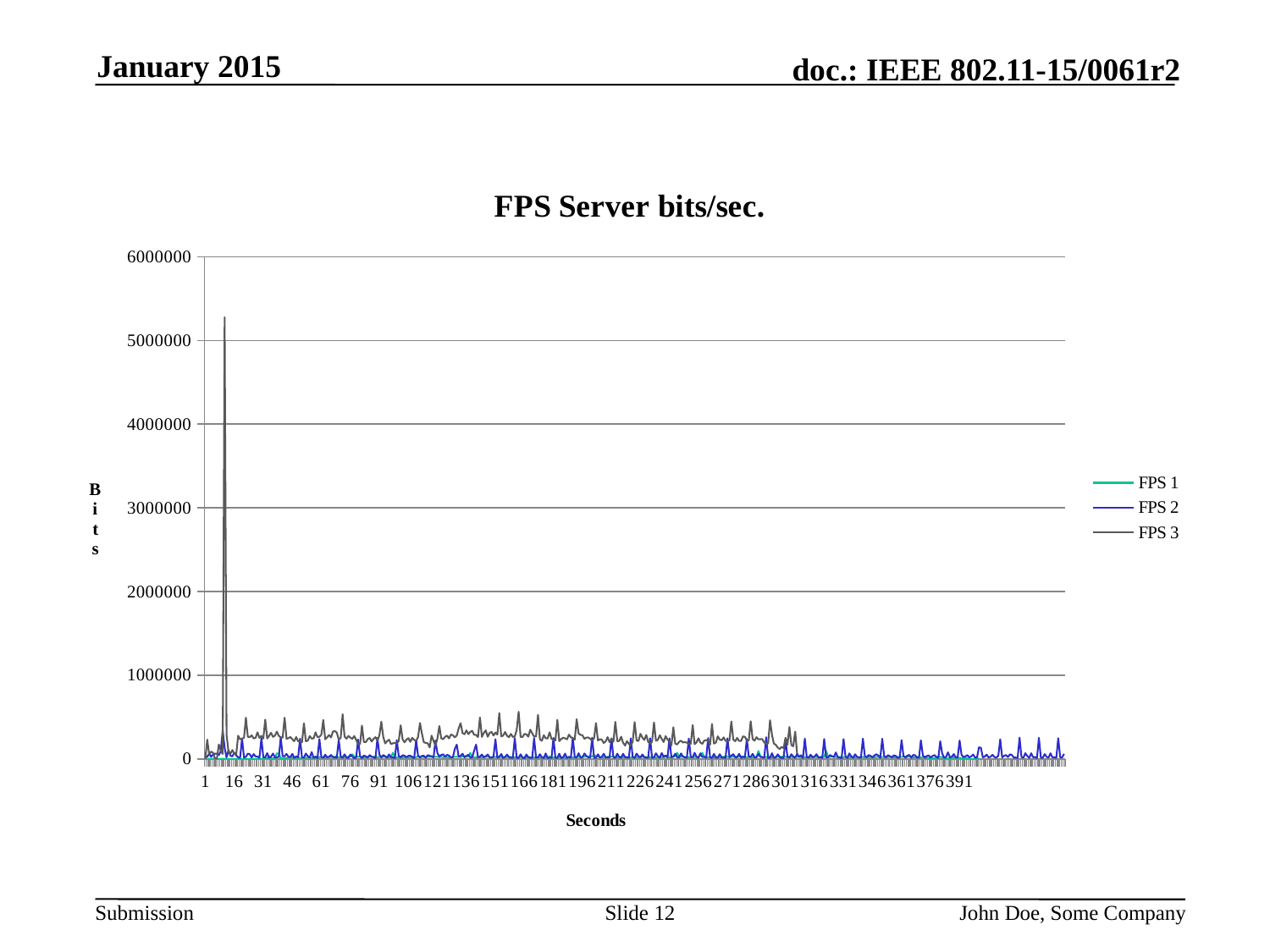
What kind of chart is shown on the slide? line chart Which series reaches the highest value on the chart? FPS 3 What are the series names listed in the legend? FPS 1, FPS 2, FPS 3 Between seconds 31 and 301, which series is generally higher, FPS 2 or FPS 3? FPS 3 Are the values of the FPS 2 series greater or less than 1000000 throughout the chart? less Is the highest peak of the FPS 3 series greater or less than 5000000? greater What is the title of the chart? FPS Server bits/sec. Is the highest peak of the FPS 3 series greater or less than 6000000? less How many series does the legend list? 3